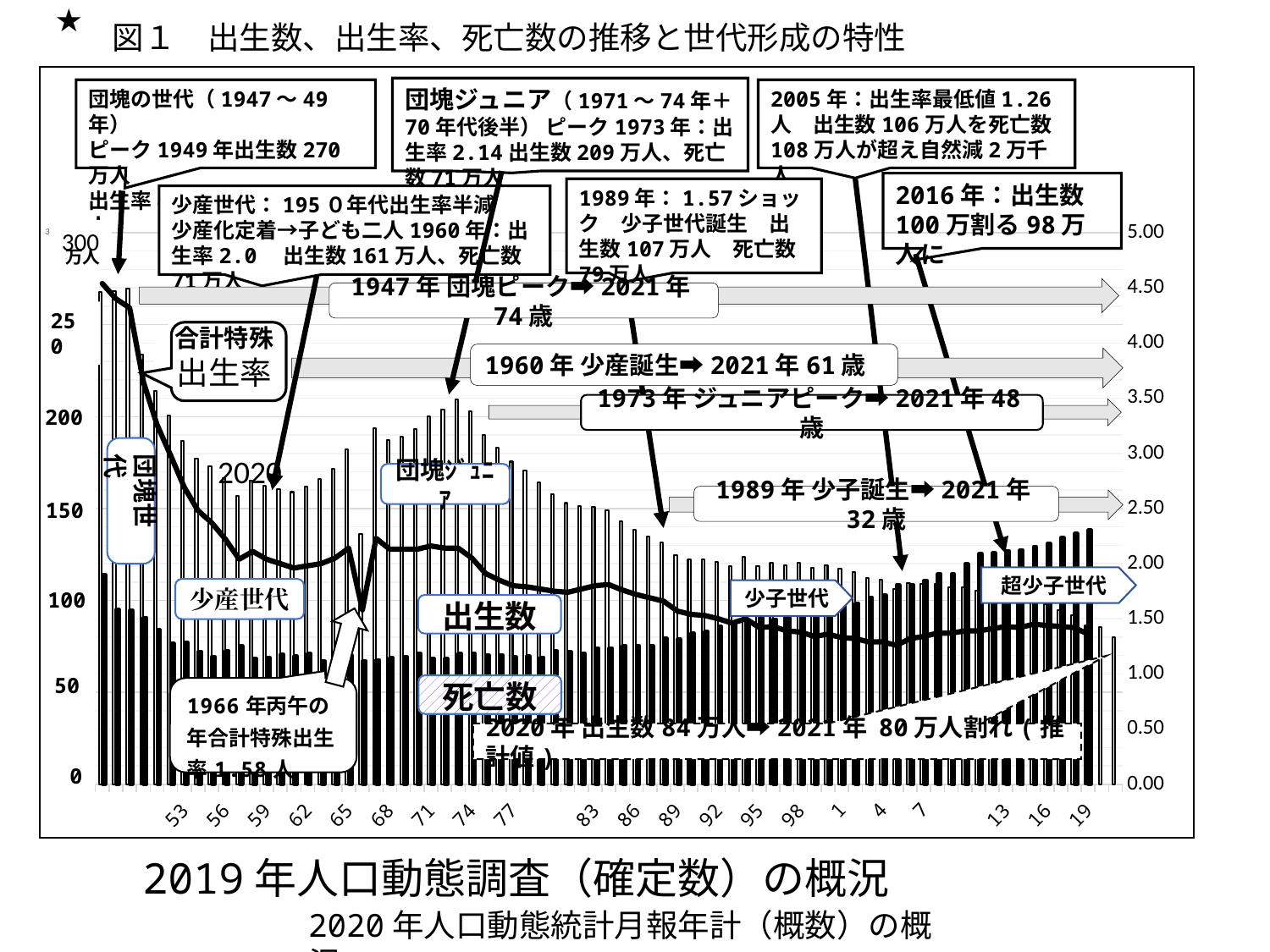
What is the highest value shown on the right-hand axis of the chart? 5.00 According to the annotation, what was the number of births in 2016? 98万人 According to the annotation, what was the number of births (出生数) at the 1949 peak? 270万人 What is the title of the chart (図１)? 出生数、出生率、死亡数の推移と世代形成の特性 Is the number of deaths (死亡数) in 2019 greater or less than 100 (万人)? greater According to the annotation, what was the total fertility rate (出生率) in 1973? 2.14 What kind of chart is shown on the slide? bar chart with a line Overall, does the number of births (出生数) rise or fall from the left to the right of the chart? fall In which year did the number of births (出生数) reach its peak? 1949年 According to the annotation, what was the lowest total fertility rate, recorded in 2005? 1.26 According to the annotation, what was the number of births in 2020? 84万人 Is the number of births (出生数) in 2019 greater or less than 100 (万人)? less